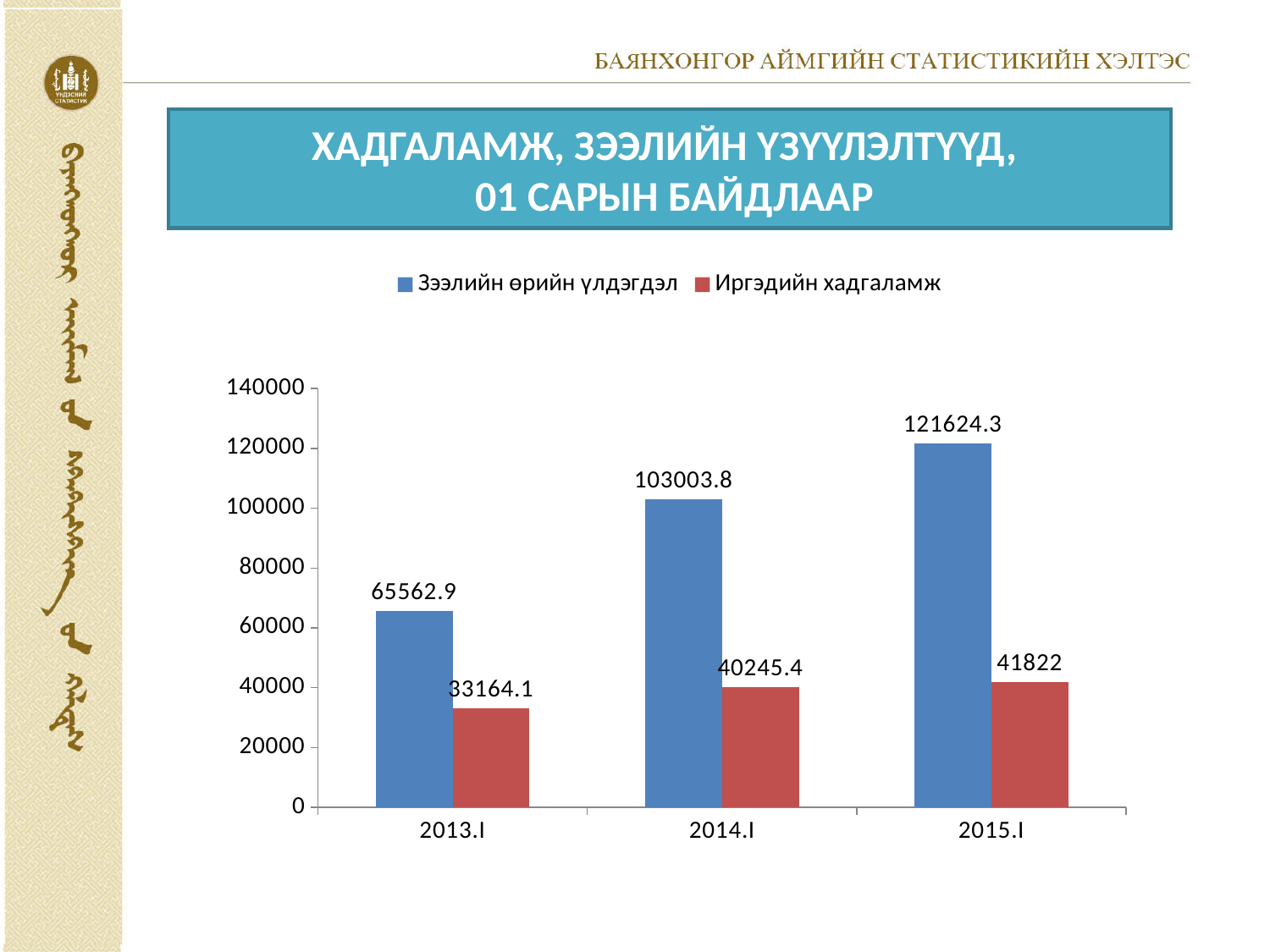
How many series does the legend list? 2 Which is larger in 2014.I: Зээлийн өрийн үлдэгдэл or Иргэдийн хадгаламж? Зээлийн өрийн үлдэгдэл How many periods are shown on the x axis? 3 In which period is Зээлийн өрийн үлдэгдэл highest? 2015.I What kind of chart is shown on the slide? Bar chart What is the value of Иргэдийн хадгаламж for 2014.I? 40245.4 What is the value of Иргэдийн хадгаламж for 2015.I? 41822 In which period is Иргэдийн хадгаламж lowest? 2013.I By how much did Зээлийн өрийн үлдэгдэл increase from 2014.I to 2015.I? 18620.5 What is the value of Зээлийн өрийн үлдэгдэл for 2013.I? 65562.9 Is the value of Зээлийн өрийн үлдэгдэл for 2014.I greater or less than 100000? greater What is the difference between Зээлийн өрийн үлдэгдэл and Иргэдийн хадгаламж in 2015.I? 79802.3